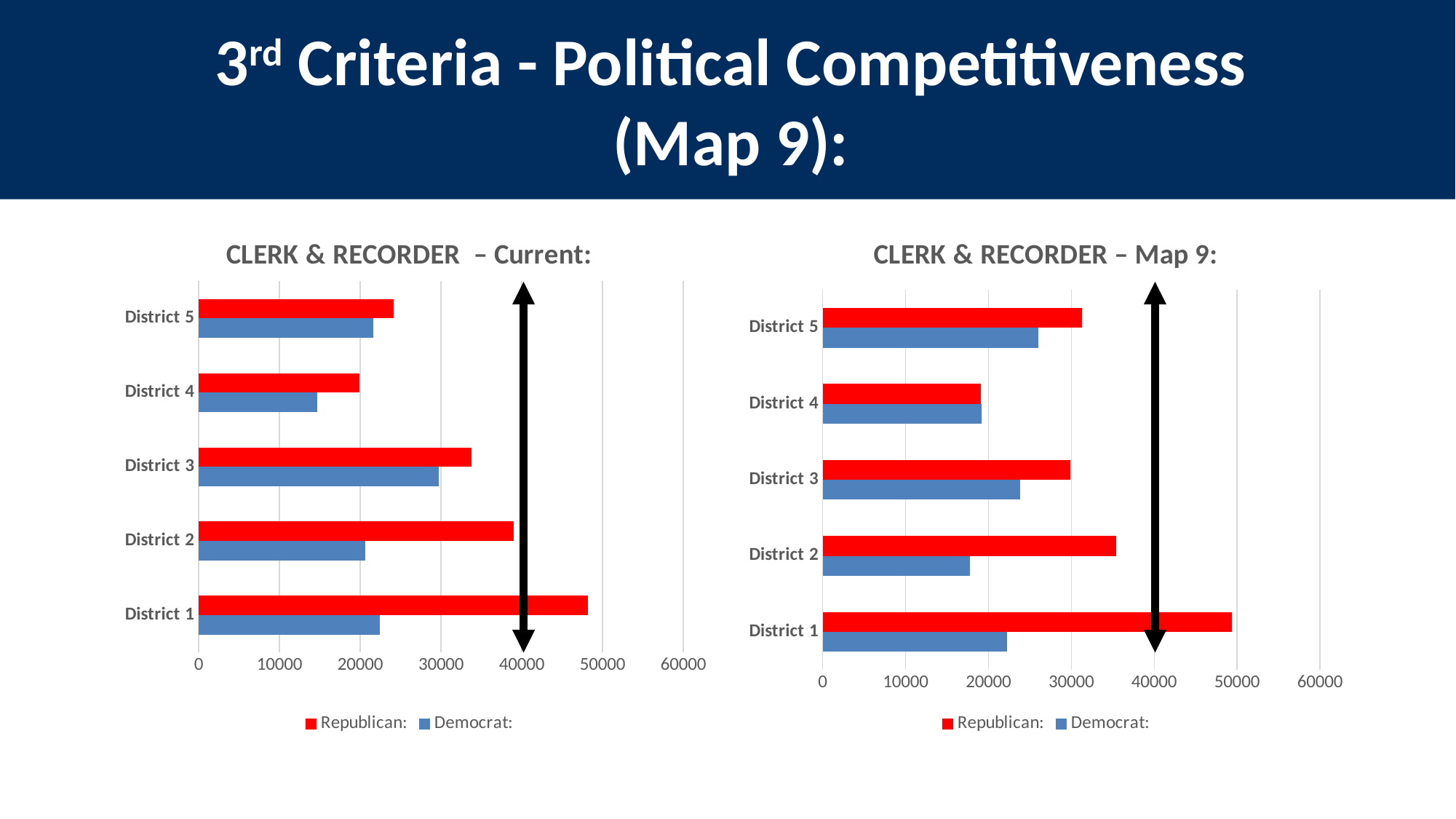
In the "CLERK & RECORDER – Map 9:" chart, which district has the lowest Republican value? District 4 In the "CLERK & RECORDER – Map 9:" chart, is the Republican value for District 2 greater or less than 30000? greater In the "CLERK & RECORDER – Map 9:" chart, which district has the highest Republican value? District 1 In the "CLERK & RECORDER – Map 9:" chart, is the Democrat value for District 2 greater or less than 20000? less What type of chart is the "CLERK & RECORDER – Current:" chart? bar chart In the "CLERK & RECORDER – Current:" chart, which district has the highest Republican value? District 1 In the "CLERK & RECORDER – Current:" chart, is the Democrat value for District 4 greater or less than 20000? less How many series does the legend of the "CLERK & RECORDER – Current:" chart list? 2 In the "CLERK & RECORDER – Map 9:" chart, which is larger for District 3, the Republican value or the Democrat value? Republican How many districts are shown in the "CLERK & RECORDER – Current:" chart? 5 In the "CLERK & RECORDER – Current:" chart, which district has the lowest Democrat value? District 4